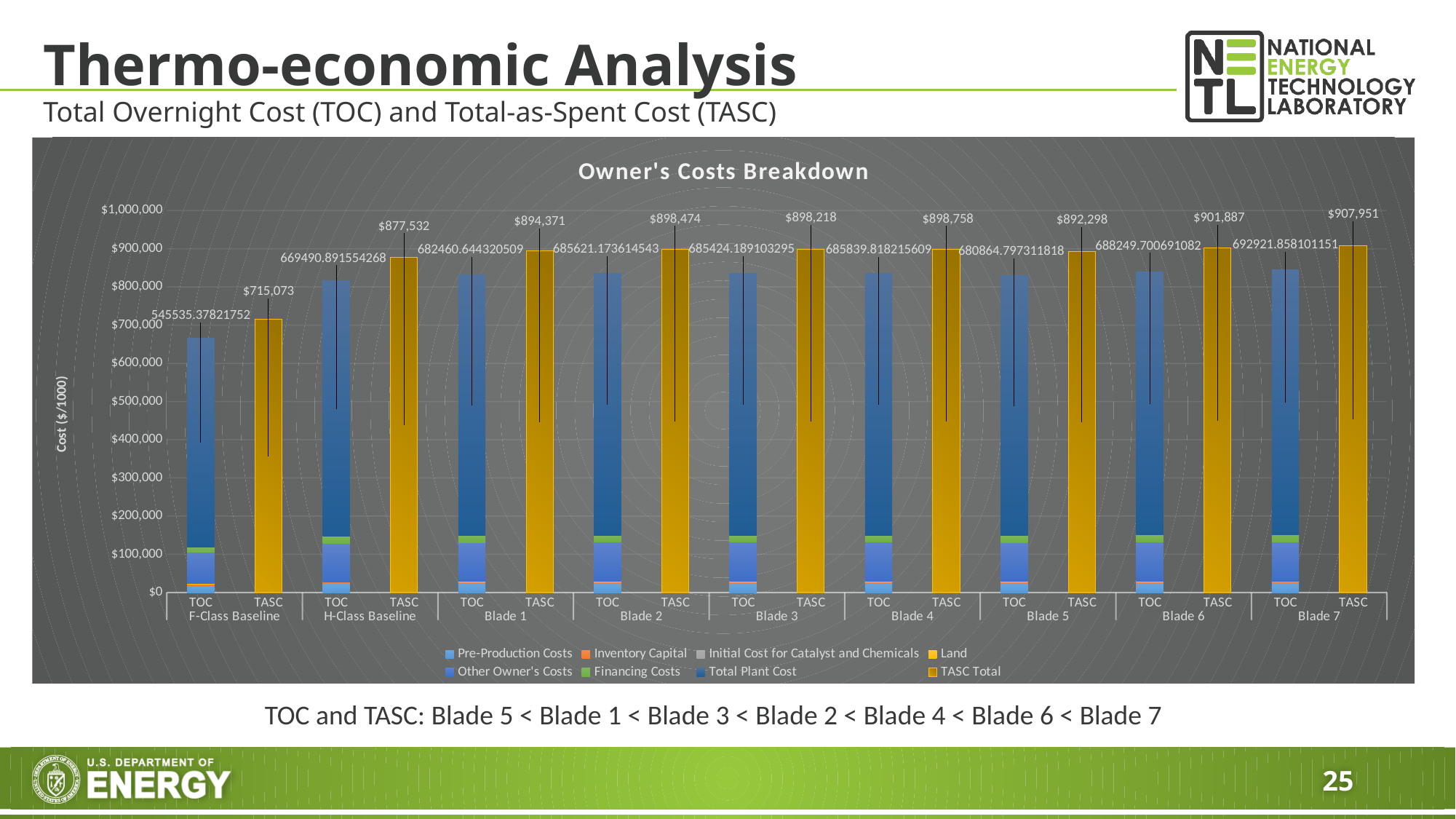
How many series does the chart legend list? 8 Is the TOC bar for F-Class Baseline greater or less than $700,000? less What is the TASC value labelled for Blade 7? $907,951 Which has the larger TASC value, Blade 1 or Blade 7? Blade 7 Which case has the lowest TASC value? F-Class Baseline What is the TASC value labelled for F-Class Baseline? $715,073 What is the title of the chart? Owner's Costs Breakdown Which case has the highest TASC value? Blade 7 What is the y-axis title of the chart? Cost ($/1000) How many plant cases (category groups) are shown along the x axis? 9 What is the difference between the TASC values for Blade 7 and F-Class Baseline? $192,878 What kind of chart is shown on the slide? Stacked bar chart